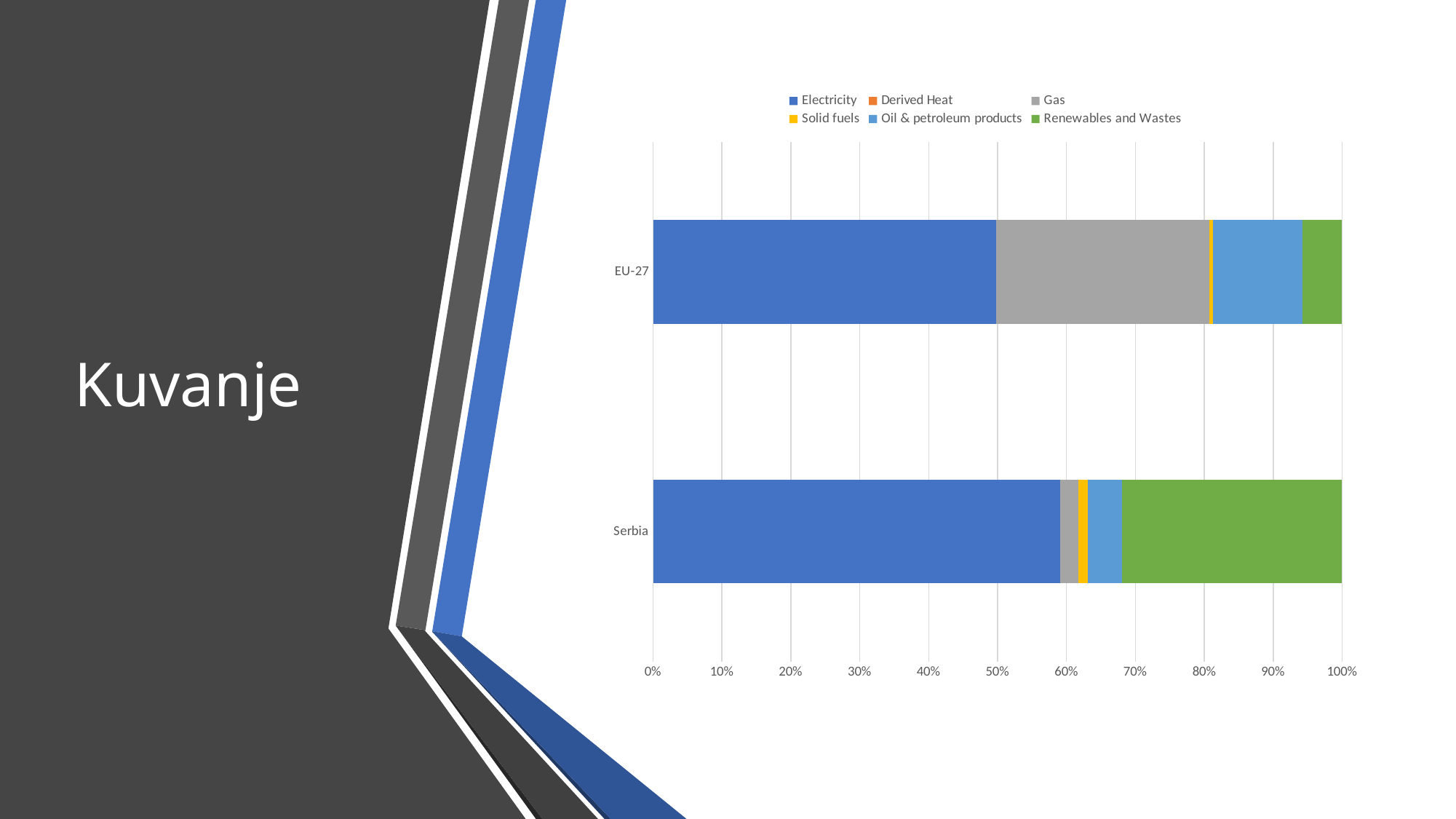
Which category has the larger Renewables and Wastes share, EU-27 or Serbia? Serbia What kind of chart is shown on the slide? Stacked bar chart How many series does the chart's legend list? 6 Is the Electricity share for Serbia greater or less than 50%? greater Which category has the larger Gas share, EU-27 or Serbia? EU-27 How many categories are plotted on the vertical axis of the chart? 2 What is the title of the slide containing the chart? Kuvanje Is the Electricity share for Serbia larger or smaller than the Electricity share for EU-27? Larger Which series makes up the largest share of the EU-27 bar? Electricity Which series makes up the largest share of the Serbia bar? Electricity Which two categories are compared in the chart? EU-27 and Serbia Is the Gas share for EU-27 greater or less than 20%? greater